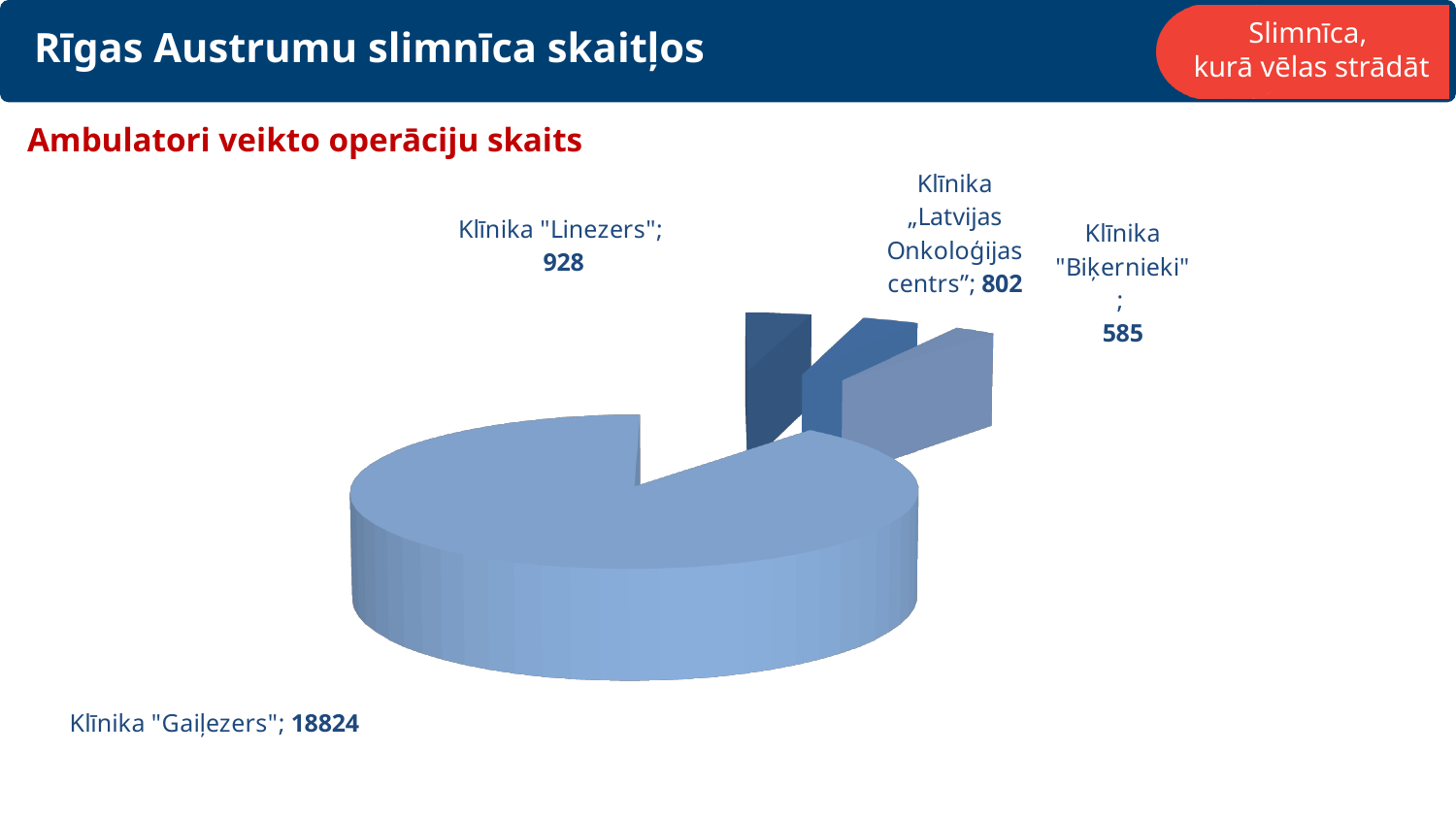
What is the difference between the values for Klīnika „Latvijas Onkoloģijas centrs" and Klīnika "Biķernieki"? 217 What is the value for Klīnika "Linezers"? 928 What is the value for Klīnika "Biķernieki"? 585 Which is larger, the value for Klīnika "Linezers" or Klīnika "Biķernieki"? Klīnika "Linezers" Which clinic has the lowest number of outpatient operations? Klīnika "Biķernieki" What type of chart is shown on the slide? pie chart How many slices does the pie chart have? 4 Which clinic has the highest number of outpatient operations? Klīnika "Gaiļezers" What is the value for Klīnika "Gaiļezers"? 18824 What is the value for Klīnika „Latvijas Onkoloģijas centrs"? 802 What is the title of the chart? Ambulatori veikto operāciju skaits What is the difference between the values for Klīnika "Linezers" and Klīnika „Latvijas Onkoloģijas centrs"? 126